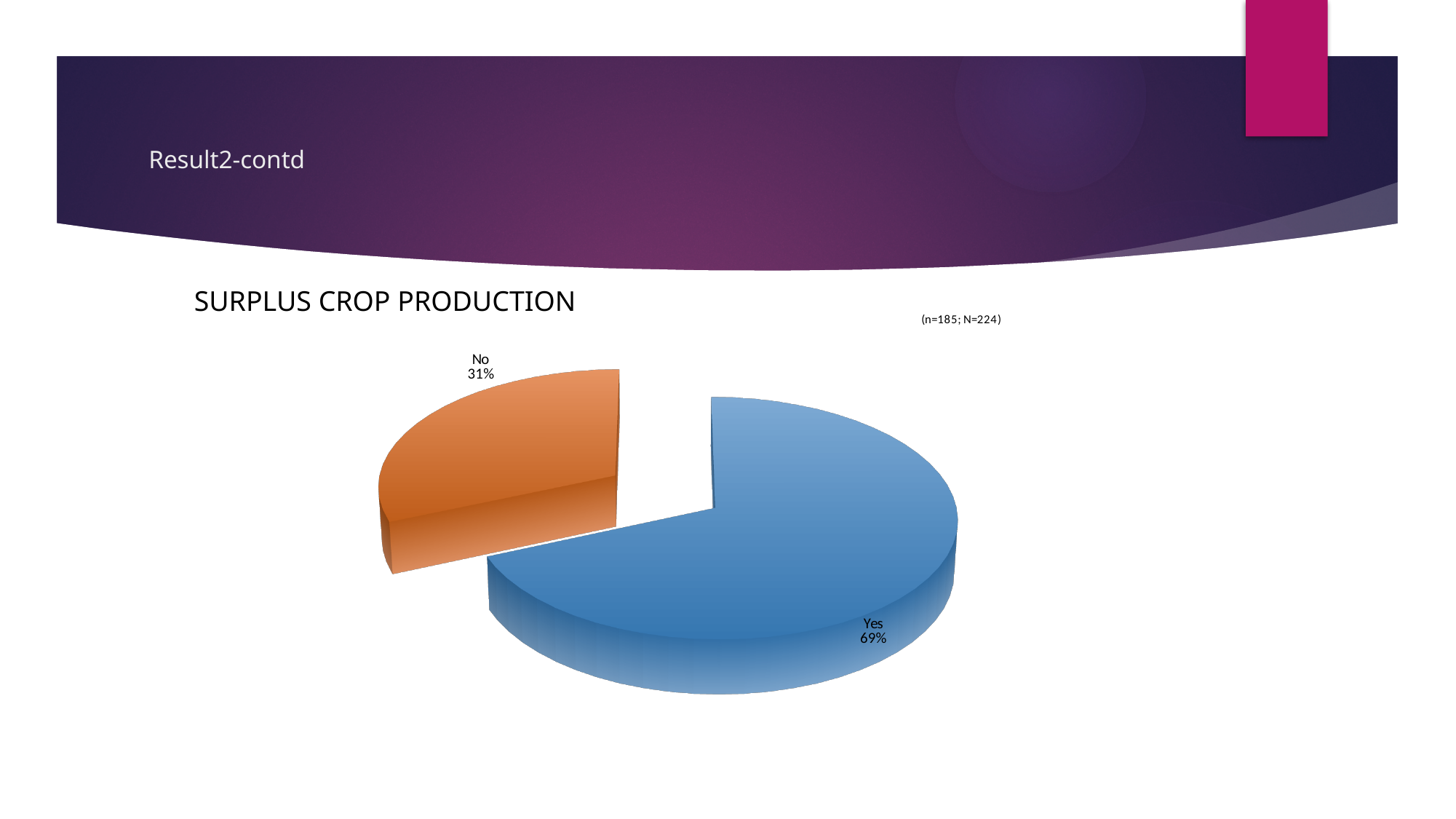
Which slice is the smallest in the pie chart? No How many slices does the pie chart have? 2 What kind of chart is shown on the slide? pie chart What is the difference in percentage points between the "Yes" and "No" slices? 38 Which is larger, the "Yes" slice or the "No" slice? Yes What colour is the "No" slice? orange What is the title of the chart? SURPLUS CROP PRODUCTION What sample size note is printed next to the chart title? (n=185; N=224) What share of the pie does the "Yes" slice represent? 69% Which slice is the largest in the pie chart? Yes What share of the pie does the "No" slice represent? 31%